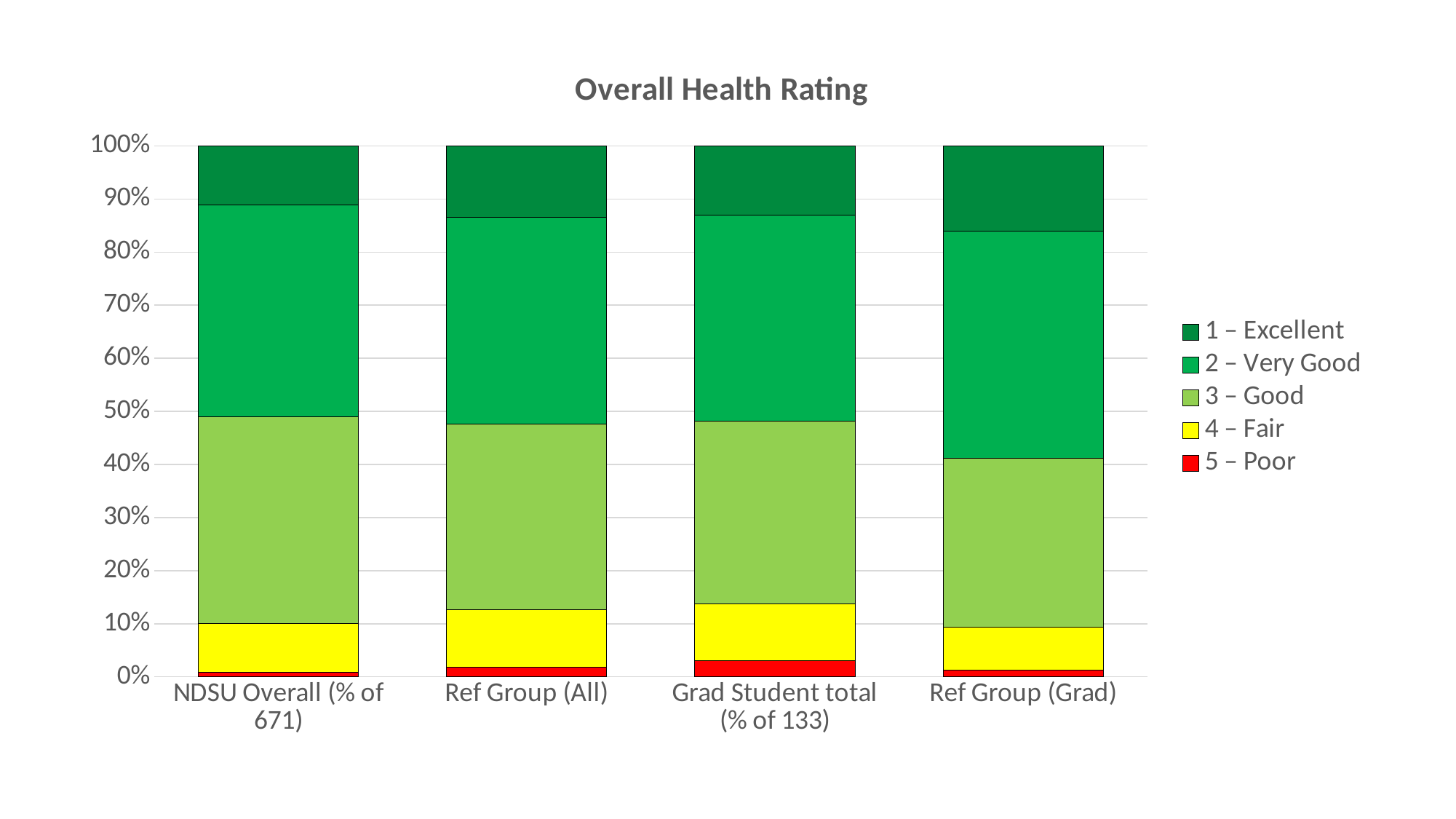
How many series does the legend list? 5 Is the "4 – Fair" share for Grad Student total (% of 133) greater or less than 20%? less Which category has the largest "1 – Excellent" segment? Ref Group (Grad) What is the title of the chart? Overall Health Rating Which category has the largest "3 – Good" segment? NDSU Overall (% of 671) Is the "1 – Excellent" share for Ref Group (Grad) greater or less than 10%? greater Which category has the largest "5 – Poor" segment? Grad Student total (% of 133) What kind of chart is shown on the slide? Stacked bar chart How many categories (bars) are shown on the x axis? 4 Which has the larger "1 – Excellent" share: NDSU Overall (% of 671) or Ref Group (Grad)? Ref Group (Grad) Is the "3 – Good" share for NDSU Overall (% of 671) greater or less than 30%? greater Which colour represents the "5 – Poor" series? Red